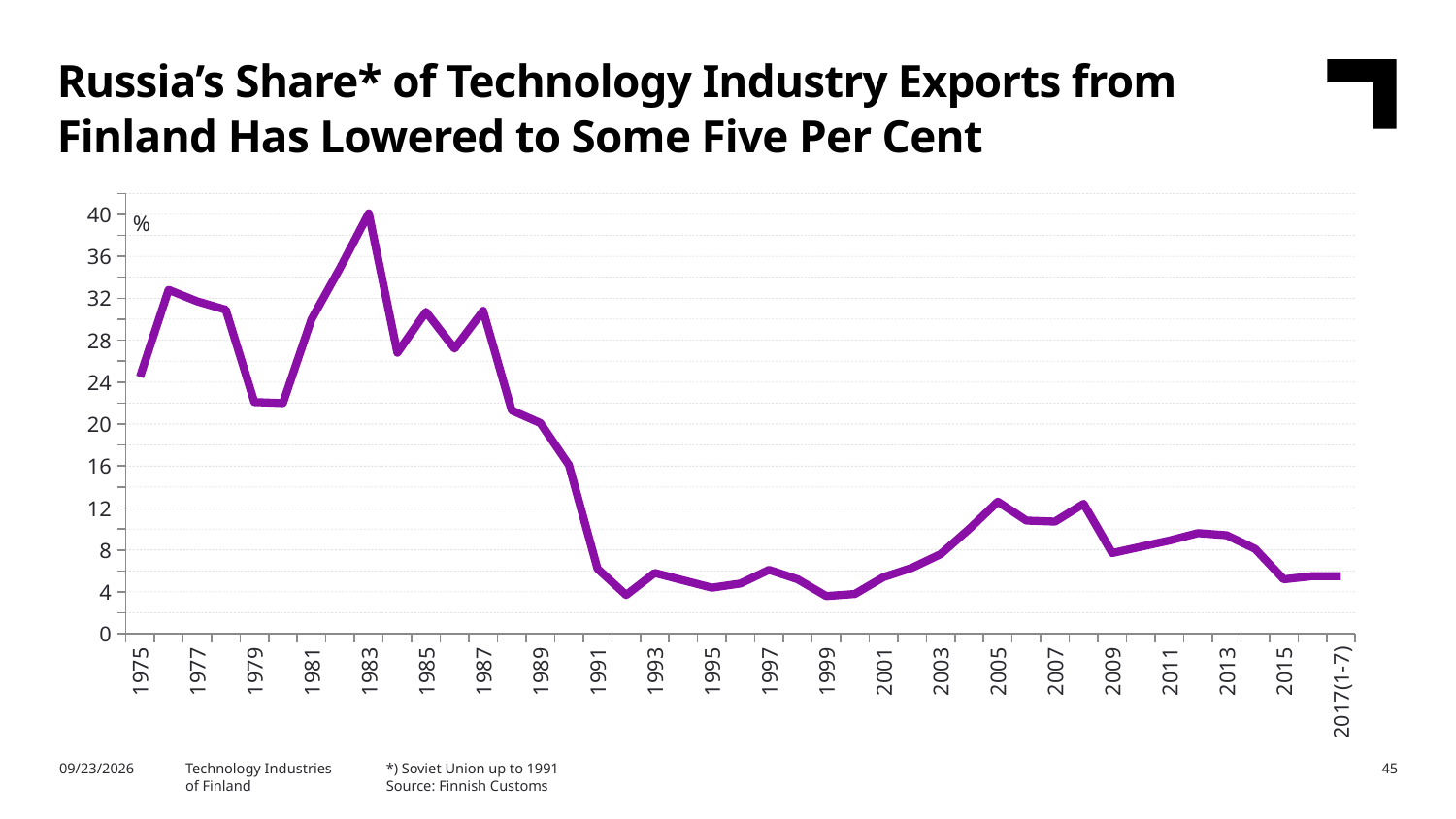
What unit is shown on the y axis of the chart? % Is the value for 1989 greater or less than 16? greater Is the value for 1975 greater or less than 20? greater Is the value for 2009 greater or less than 12? less In which year does Russia's share of technology industry exports from Finland reach its highest value? 1983 Which year has the larger value, 1983 or 2005? 1983 Does the value rise or fall between 1983 and 1991? fall Does the value rise or fall between 1999 and 2005? rise What kind of chart is shown on the slide? line chart